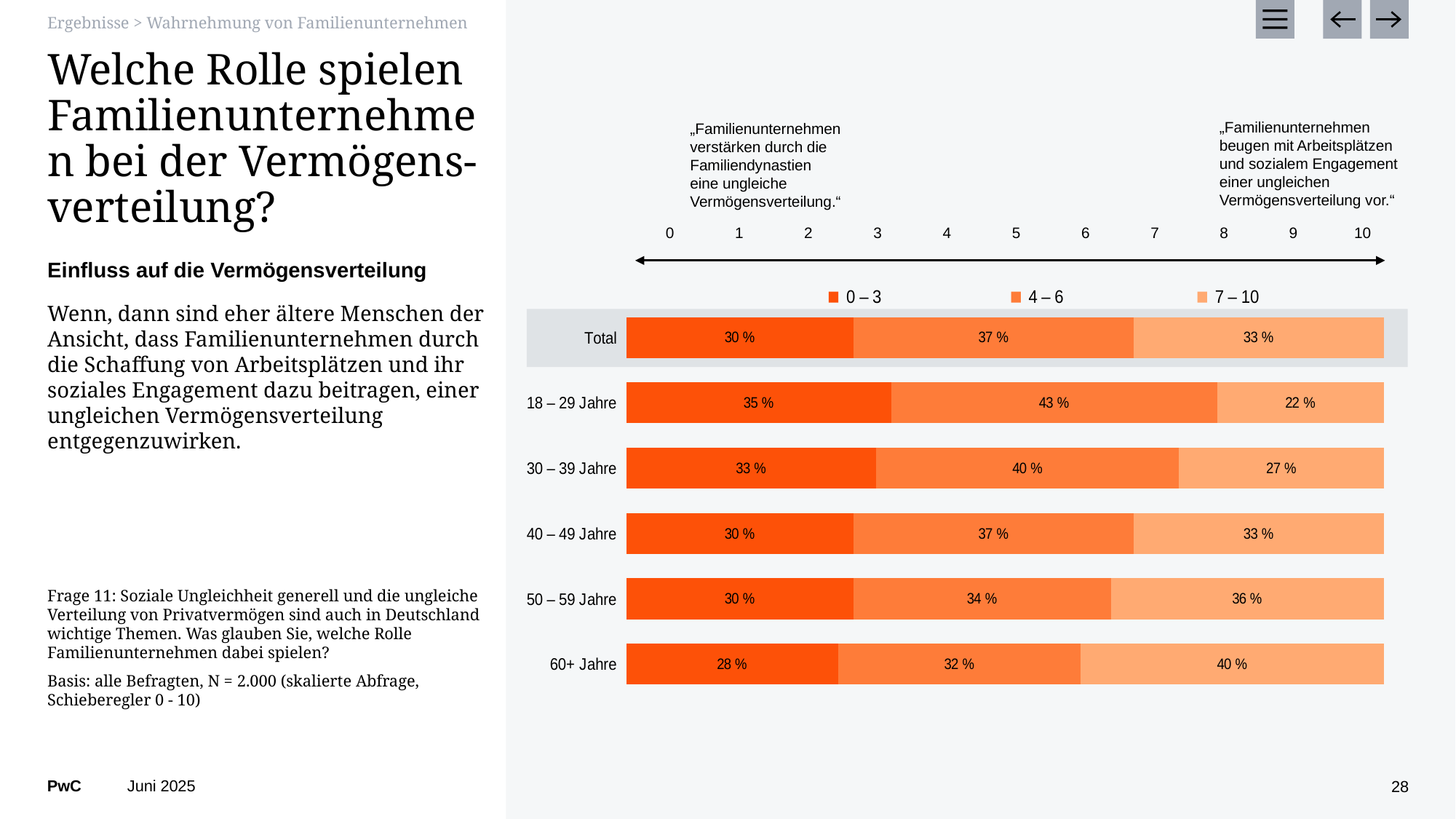
Which age group has the lowest value in the "0 – 3" series? 60+ Jahre Which is larger: the "4 – 6" value for "30 – 39 Jahre" or for "50 – 59 Jahre"? 30 – 39 Jahre How many age groups (including Total) are shown in the chart? 6 Which legend entry is shown in the darkest orange colour? 0 – 3 What is the value of the "0 – 3" segment for "Total"? 30 % What is the value of the "7 – 10" segment for the "60+ Jahre" group? 40 % What kind of chart is shown on the slide? Stacked bar chart What is the value of the "4 – 6" segment for the "18 – 29 Jahre" group? 43 % What is the total of the three segments for the "50 – 59 Jahre" bar? 100 % Which age group has the highest value in the "7 – 10" series? 60+ Jahre What is the difference between the "7 – 10" values for "60+ Jahre" and "18 – 29 Jahre"? 18 % How many series does the legend list? 3